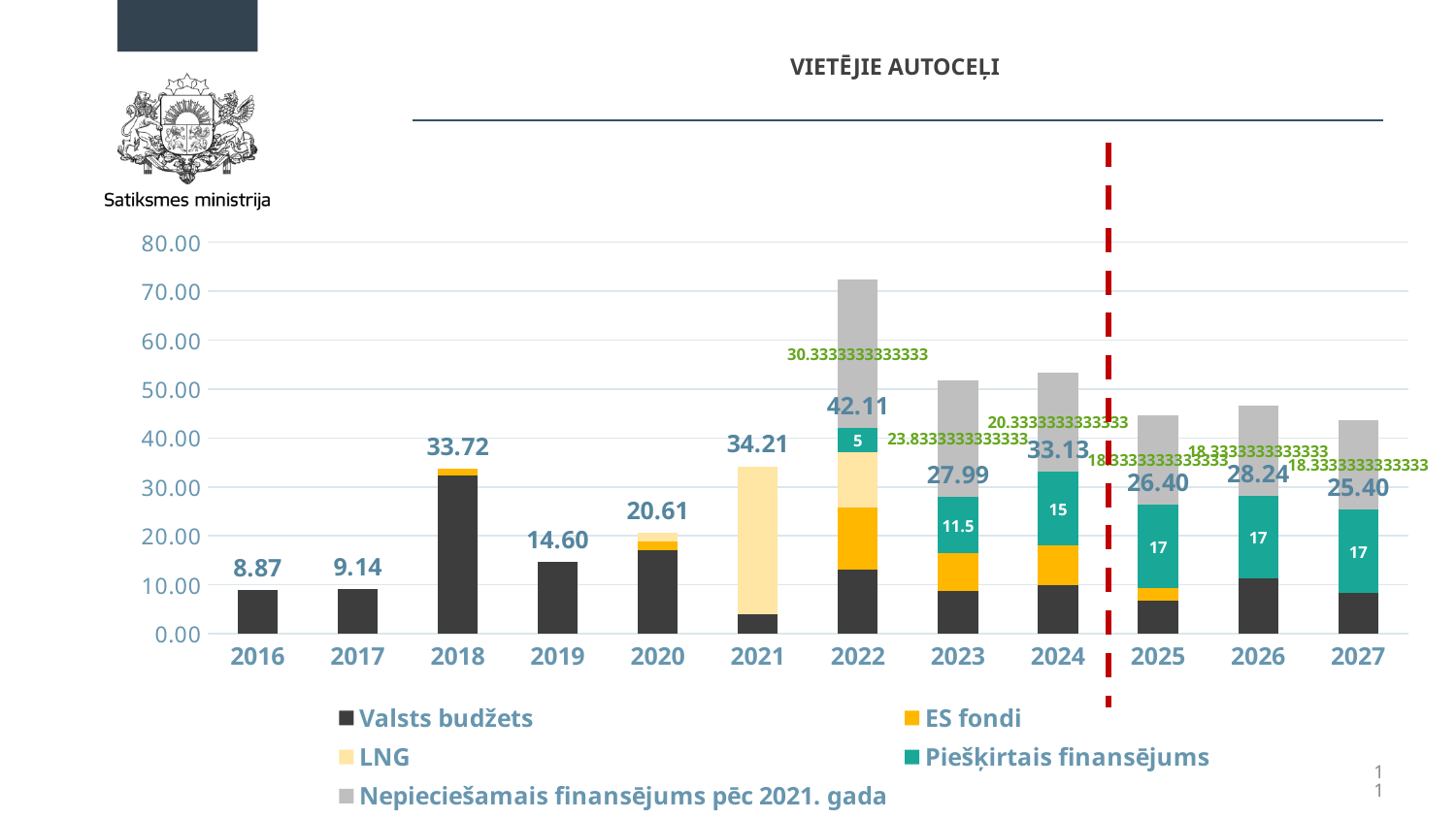
What value is printed on the Piešķirtais finansējums segment for 2024? 15 What is the difference between the labelled values for 2018 and 2019? 19.12 What is the difference between the labelled values for 2026 and 2027? 2.84 What is the labelled value for 2018? 33.72 How many years are shown on the x axis? 12 How many series does the legend list? 5 Which year has the highest labelled value above its bar? 2022 What value is printed on the Piešķirtais finansējums segment for 2023? 11.5 What is the labelled value for 2022? 42.11 Which year has the lowest labelled value above its bar? 2016 Is the total height of the 2025 bar greater or less than 50.00? less Which labelled value is larger, 2021 or 2018? 2021